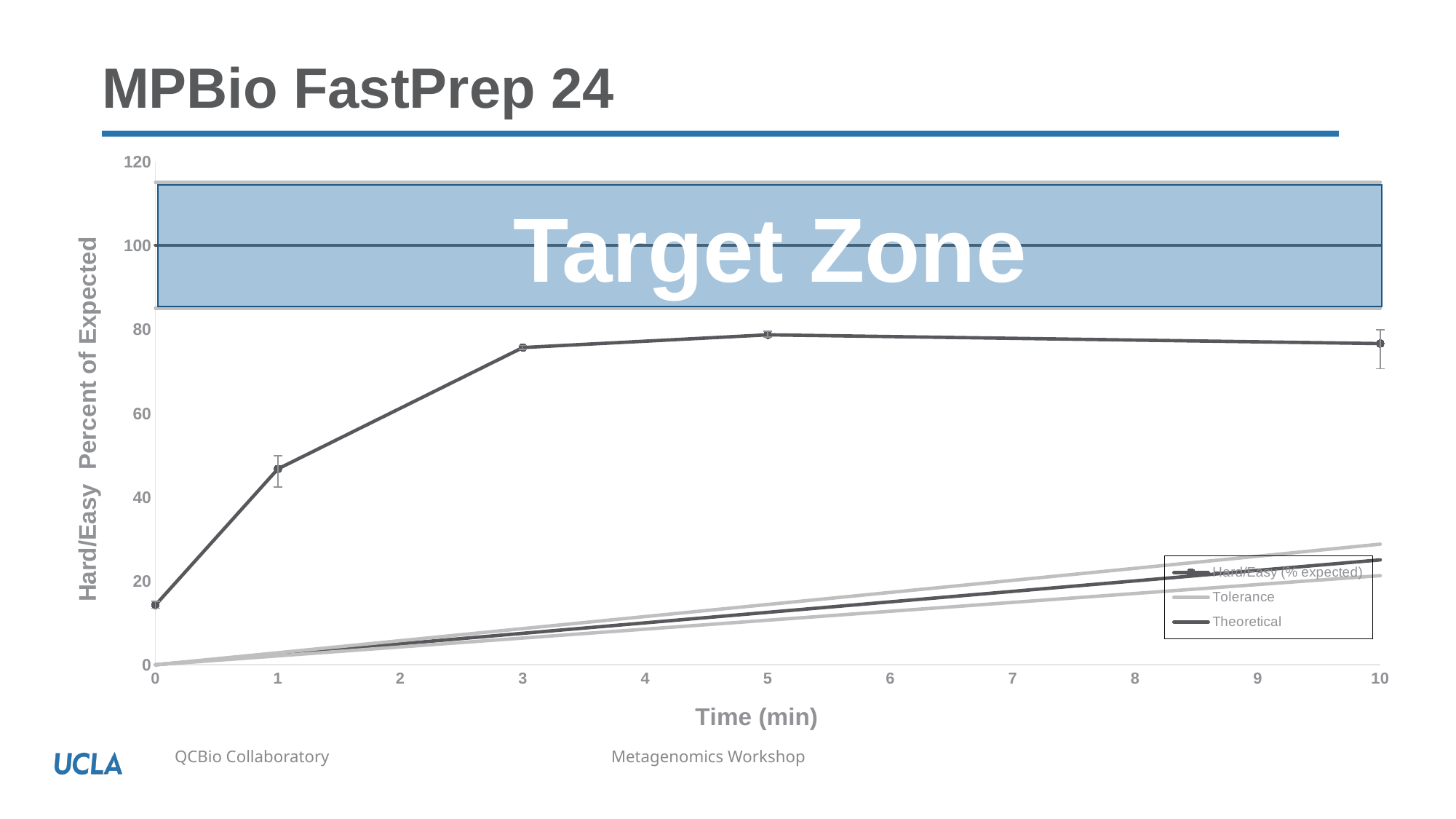
What kind of chart is shown on the slide? line chart Does the Hard/Easy (% expected) series ever reach the Target Zone? No What is the title of the x axis? Time (min) Is the Hard/Easy (% expected) value at 1 min greater or less than 40? greater How many series does the legend list? 3 Is the Hard/Easy (% expected) value at 0 min greater or less than 20? less Does the Hard/Easy (% expected) series rise or fall between 0 min and 5 min? rise Which is larger for the Hard/Easy (% expected) series: the value at 1 min or the value at 3 min? 3 min What label is written inside the shaded band on the chart? Target Zone How many marked data points does the Hard/Easy (% expected) series have? 5